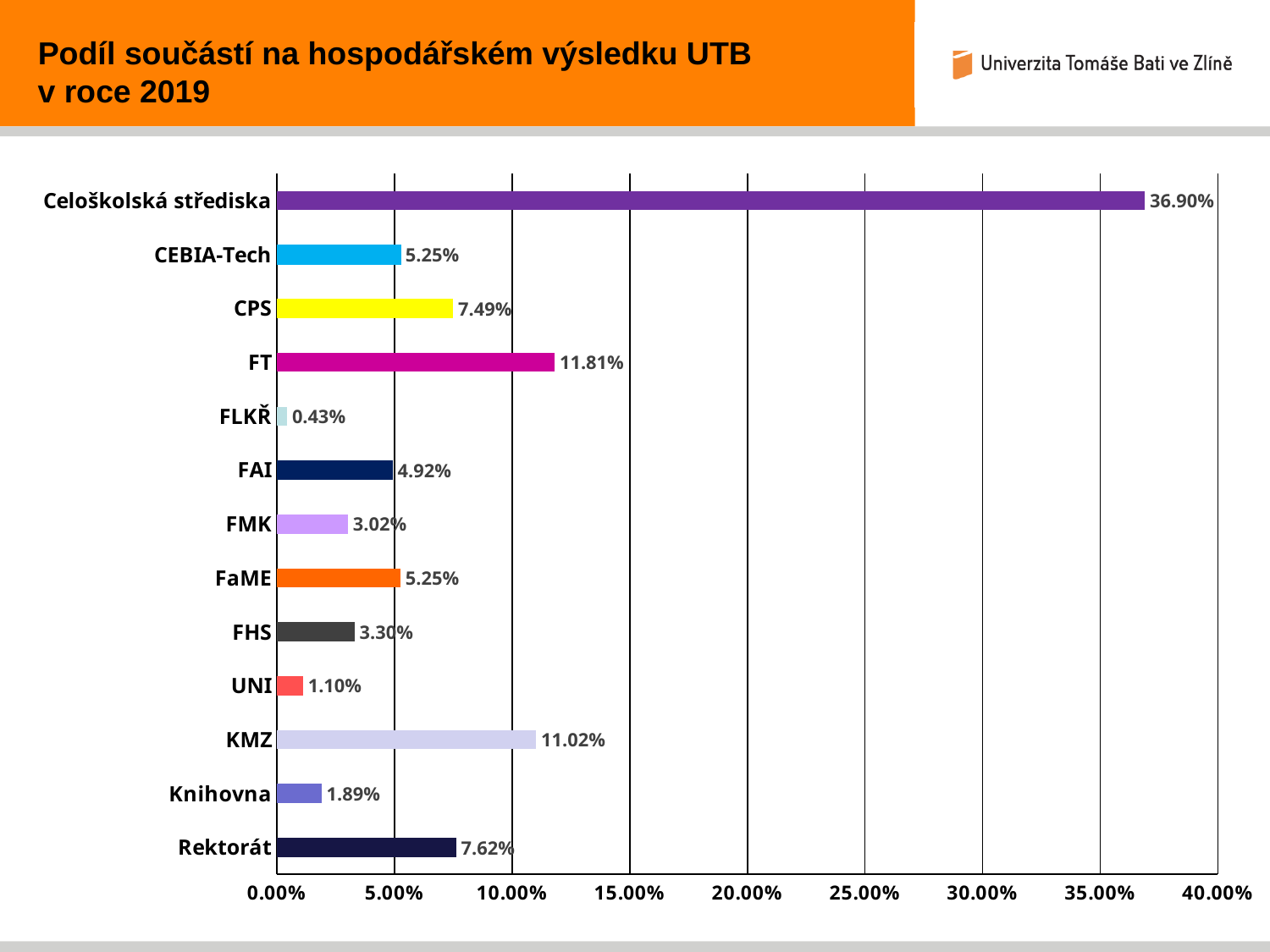
What kind of chart is shown on the slide? bar chart What is the title of the slide? Podíl součástí na hospodářském výsledku UTB v roce 2019 Is the value for Celoškolská střediska greater or less than 35.00%? greater Which is larger, the value for FAI or the value for FHS? FAI What is the difference between the values for FT and KMZ? 0.79% How many categories are shown in the chart? 13 What is the value for FT? 11.81% Which category has the highest value? Celoškolská střediska What is the value for KMZ? 11.02% What is the difference between the values for Rektorát and CPS? 0.13% Which category has the lowest value? FLKŘ What is the value for Knihovna? 1.89%